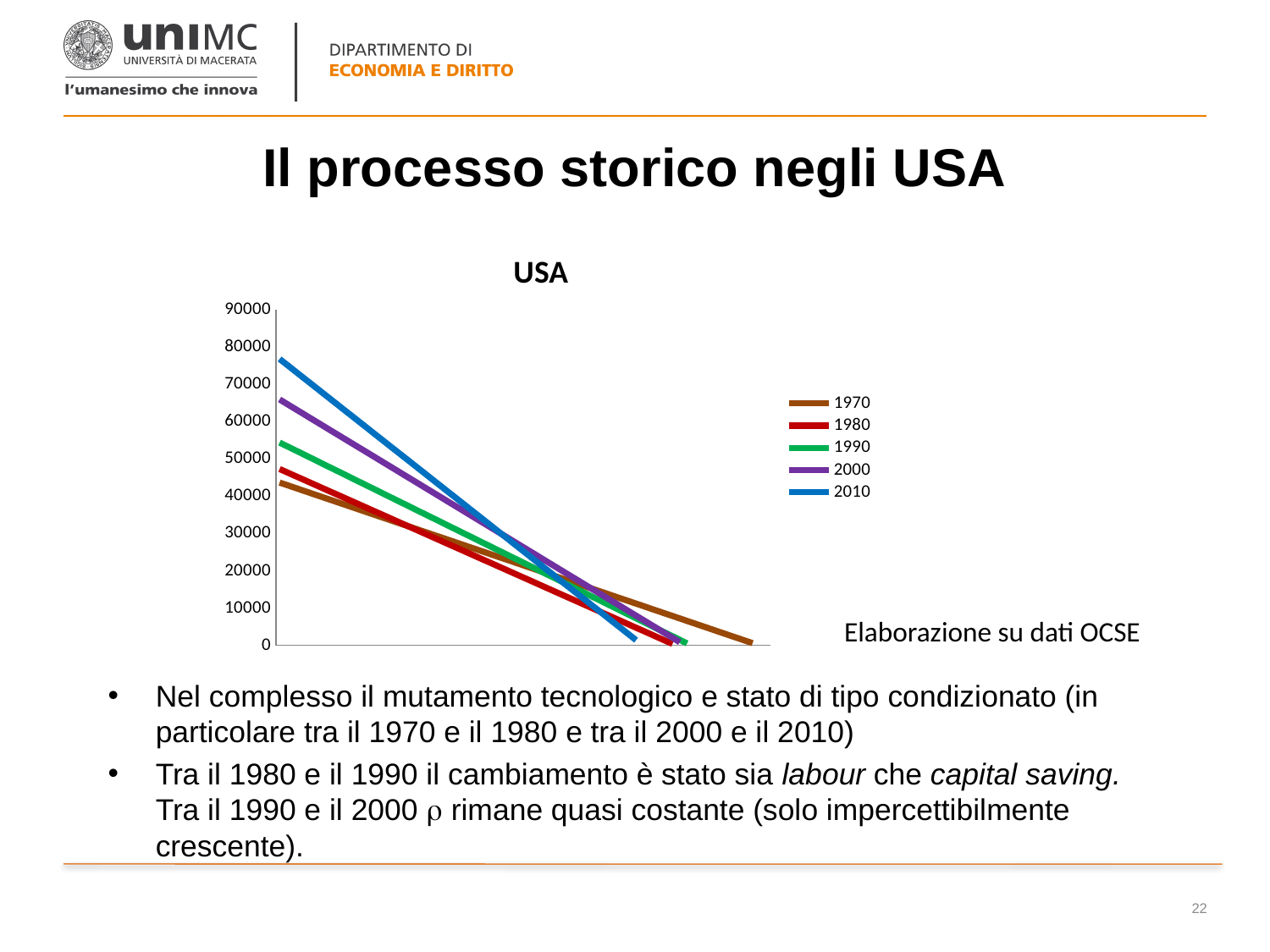
Do the lines in the USA chart rise or fall from left to right? fall At the left edge of the chart, which line starts higher: 1990 or 1980? 1990 How many series does the legend of the USA chart list? 5 What is the highest value shown on the vertical axis of the chart? 90000 Which years are listed in the legend of the chart? 1970, 1980, 1990, 2000, 2010 Which series starts at the highest value on the left side of the chart? 2010 Is the starting value of the 1970 line greater or less than 50000? less Is the starting value of the 2000 line greater or less than 60000? greater Which series starts at the lowest value on the left side of the chart? 1970 What kind of chart is shown on the slide? line chart Is the starting value of the 2010 line greater or less than 70000? greater What is the title of the chart? USA